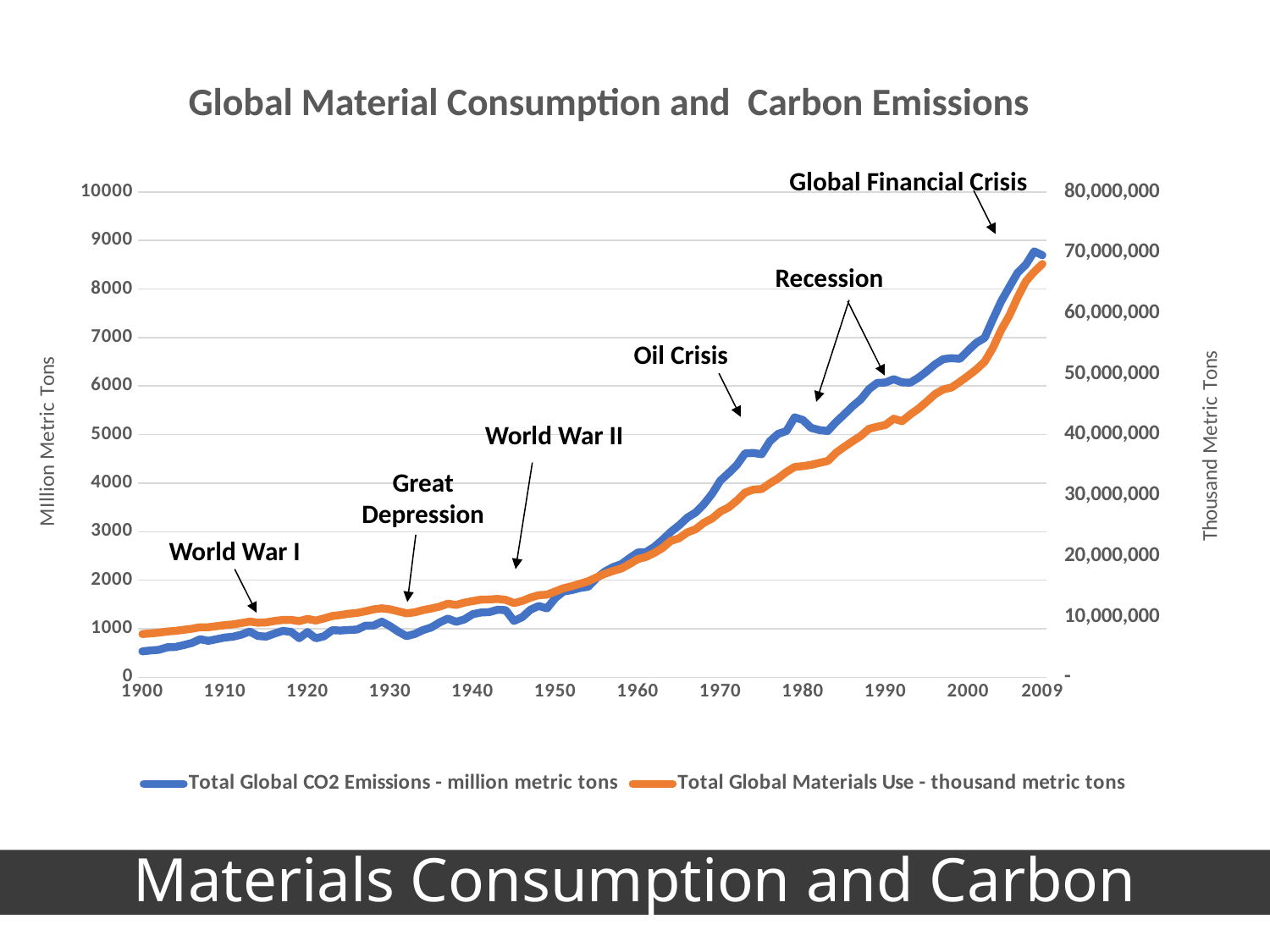
Which historical event is annotated closest to the year 2009 on the chart? Global Financial Crisis Is the value for Total Global CO2 Emissions in 1900 greater or less than 1000 million metric tons? less Is the value for Total Global Materials Use in 1900 greater or less than 10,000,000 thousand metric tons? less Is the value for Total Global CO2 Emissions in 1950 greater or less than 2000 million metric tons? less Do the Total Global Materials Use values generally rise or fall from 1900 to 2009? Rise How many series does the legend list? 2 Do the Total Global CO2 Emissions values generally rise or fall from 1900 to 2009? Rise What is the title of the chart? Global Material Consumption and Carbon Emissions What kind of chart is shown on the slide? Line chart